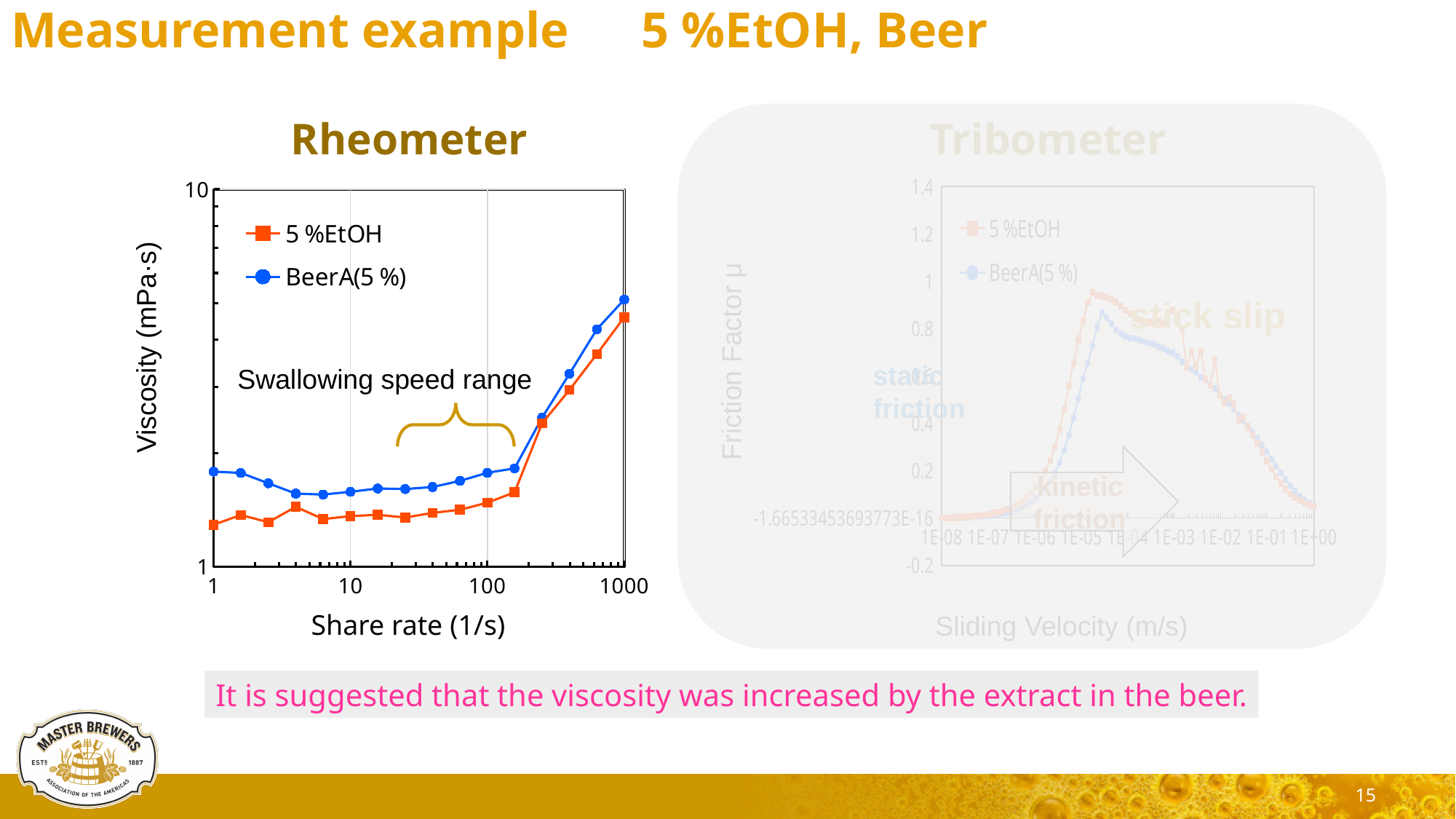
In the Rheometer chart, which series has the higher viscosity at a share rate of 1 (1/s), 5 %EtOH or BeerA(5 %)? BeerA(5 %) In the Rheometer chart, does the viscosity of 5 %EtOH rise or fall as the share rate increases from 100 to 1000 (1/s)? rise In the Rheometer chart, is the viscosity of BeerA(5 %) at a share rate of 1000 (1/s) greater or less than 10 mPa·s? less In the Rheometer chart, which series has the higher viscosity at a share rate of 10 (1/s), 5 %EtOH or BeerA(5 %)? BeerA(5 %) In the Rheometer chart, at which share rate does BeerA(5 %) reach its highest viscosity? 1000 What annotation is written above the brace in the Rheometer chart? Swallowing speed range In the Rheometer chart, is the viscosity of 5 %EtOH at a share rate of 1 (1/s) greater or less than 1 mPa·s? greater How many series does the legend of the Tribometer chart list? 2 What is the x-axis title of the Rheometer chart? Share rate (1/s) How many data points are plotted for the 5 %EtOH series in the Rheometer chart? 16 How many series does the legend of the Rheometer chart list? 2 What kind of chart is the Rheometer chart? line chart